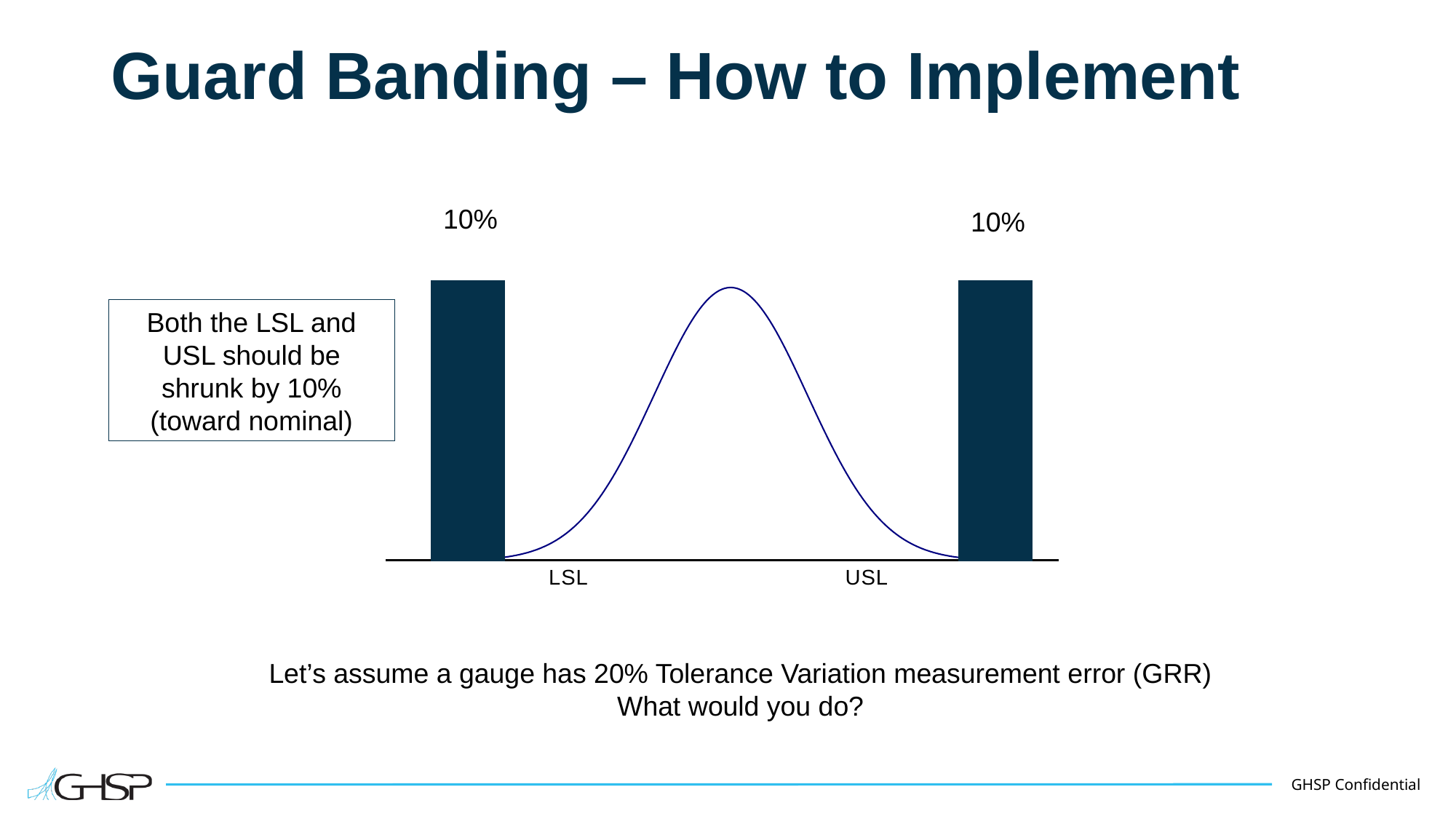
What percentage label appears above the left dark bar in the diagram? 10% What label is printed below the axis on the right side of the bell curve? USL How many dark vertical bars are drawn in the diagram? 2 What label is printed below the axis on the left side of the bell curve? LSL What percentage label appears above the right dark bar in the diagram? 10% Are the percentage labels above the two dark bars the same or different? the same What shape is the curve drawn between the LSL and USL labels? a bell curve Where is the peak of the bell curve located relative to the LSL and USL labels? midway between them According to the text box, by what percentage should both the LSL and USL be shrunk? 10% What Tolerance Variation measurement error (GRR) does the slide assume the gauge has? 20%